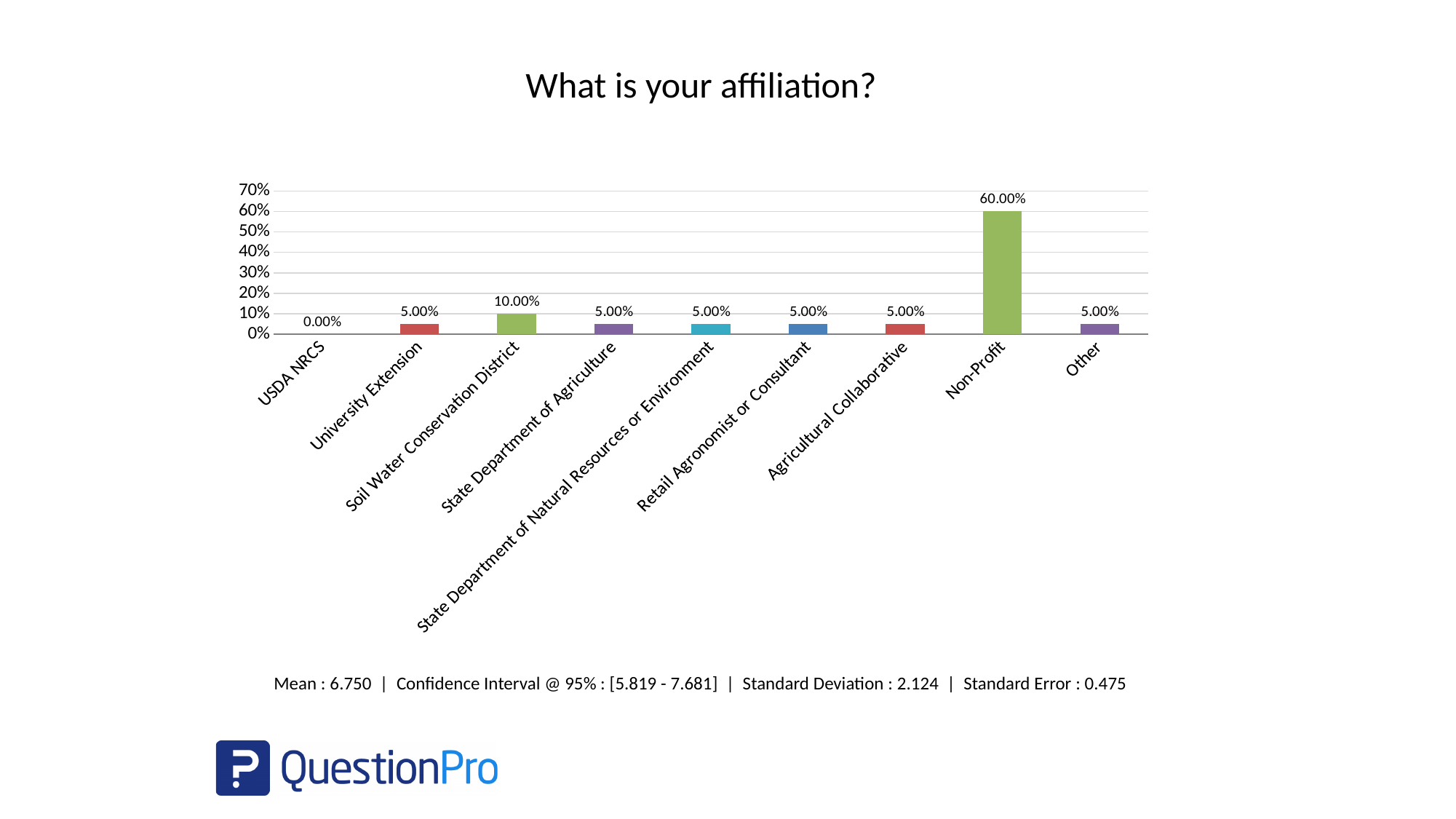
What is the value for Soil Water Conservation District? 10.00% Which is larger, the value for Soil Water Conservation District or the value for Other? Soil Water Conservation District Which category has the lowest value? USDA NRCS What is the difference between the values for Non-Profit and Soil Water Conservation District? 50.00% What kind of chart is shown on the slide? bar chart Which category has the highest value? Non-Profit What is the value for USDA NRCS? 0.00% What is the value for Non-Profit? 60.00% What is the value for University Extension? 5.00% Is the value for Non-Profit greater or less than 50%? greater What is the title of the chart? What is your affiliation? How many categories are shown on the x axis? 9